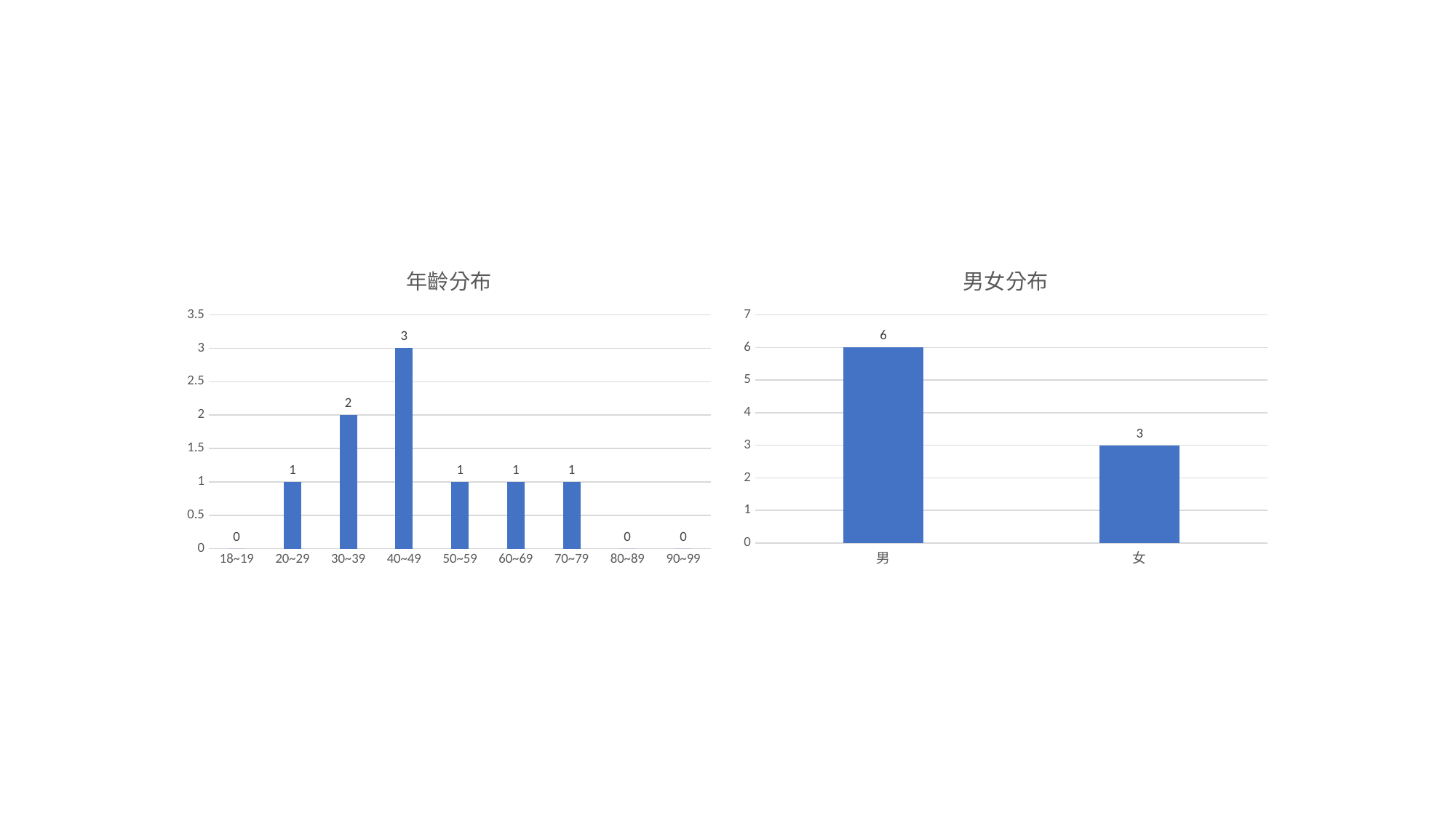
In the 年齢分布 chart, what is the value for 40~49? 3 What kind of chart is the 男女分布 chart? Bar chart In the 男女分布 chart, what is the value for 男? 6 In the 年齢分布 chart, what is the value for 30~39? 2 In the 年齢分布 chart, what is the difference between the values for 40~49 and 20~29? 2 In the 年齢分布 chart, how many age group categories are shown on the x axis? 9 In the 男女分布 chart, what is the difference between the values for 男 and 女? 3 In the 年齢分布 chart, which age group has the highest value? 40~49 In the 年齢分布 chart, what is the value for 80~89? 0 In the 男女分布 chart, what is the value for 女? 3 What is the title of the chart on the left side of the slide? 年齡分布 In the 年齢分布 chart, which is larger, the value for 30~39 or the value for 50~59? 30~39